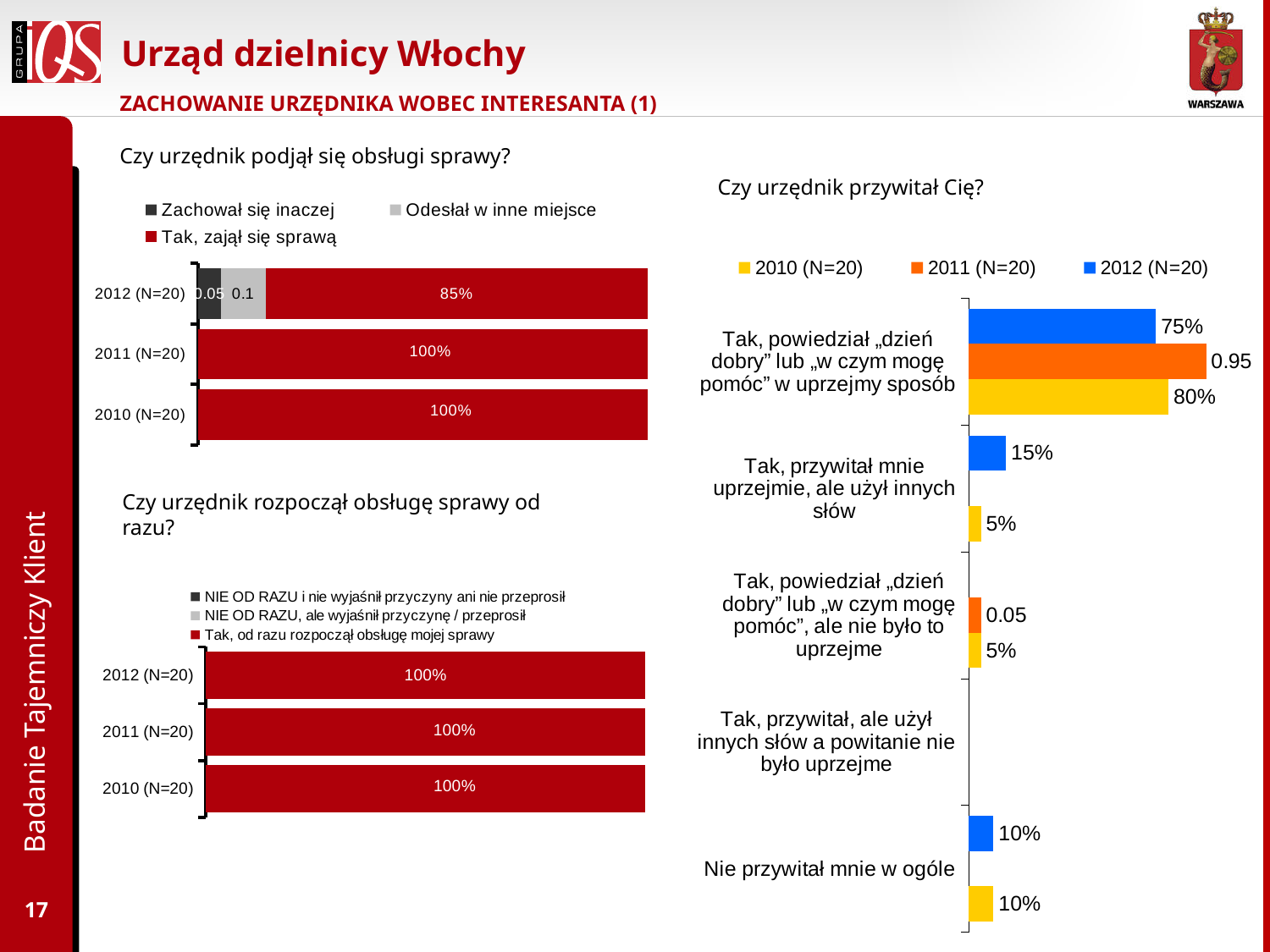
In the chart "Czy urzędnik podjął się obsługi sprawy?", what is the value for "Tak, zajął się sprawą" in 2012 (N=20)? 85% In the chart "Czy urzędnik rozpoczął obsługę sprawy od razu?", what is the value for "Tak, od razu rozpoczął obsługę mojej sprawy" in 2010 (N=20)? 100% How many series does the legend of the chart "Czy urzędnik podjął się obsługi sprawy?" list? 3 In the chart "Czy urzędnik podjął się obsługi sprawy?", what is the value for "Tak, zajął się sprawą" in 2011 (N=20)? 100% In the chart "Czy urzędnik przywitał Cię?", which year has the highest value in the category "Tak, powiedział „dzień dobry" lub „w czym mogę pomóc" w uprzejmy sposób"? 2011 (N=20) What kind of chart is "Czy urzędnik rozpoczął obsługę sprawy od razu?"? bar chart In the chart "Czy urzędnik przywitał Cię?", what is the value for 2012 (N=20) in the category "Tak, przywitał mnie uprzejmie, ale użył innych słów"? 15% In the chart "Czy urzędnik podjął się obsługi sprawy?", what is the value for "Odesłał w inne miejsce" in 2012 (N=20)? 0.1 In the chart "Czy urzędnik przywitał Cię?", what is the difference between the 2010 (N=20) and 2012 (N=20) values in the category "Tak, przywitał mnie uprzejmie, ale użył innych słów"? 10% In the chart "Czy urzędnik przywitał Cię?", what is the value for 2012 (N=20) in the category "Tak, powiedział „dzień dobry" lub „w czym mogę pomóc" w uprzejmy sposób"? 75% In the chart "Czy urzędnik przywitał Cię?", what is the value for 2011 (N=20) in the category "Tak, powiedział „dzień dobry" lub „w czym mogę pomóc" w uprzejmy sposób"? 0.95 How many categories are shown on the y axis of the chart "Czy urzędnik przywitał Cię?"? 5